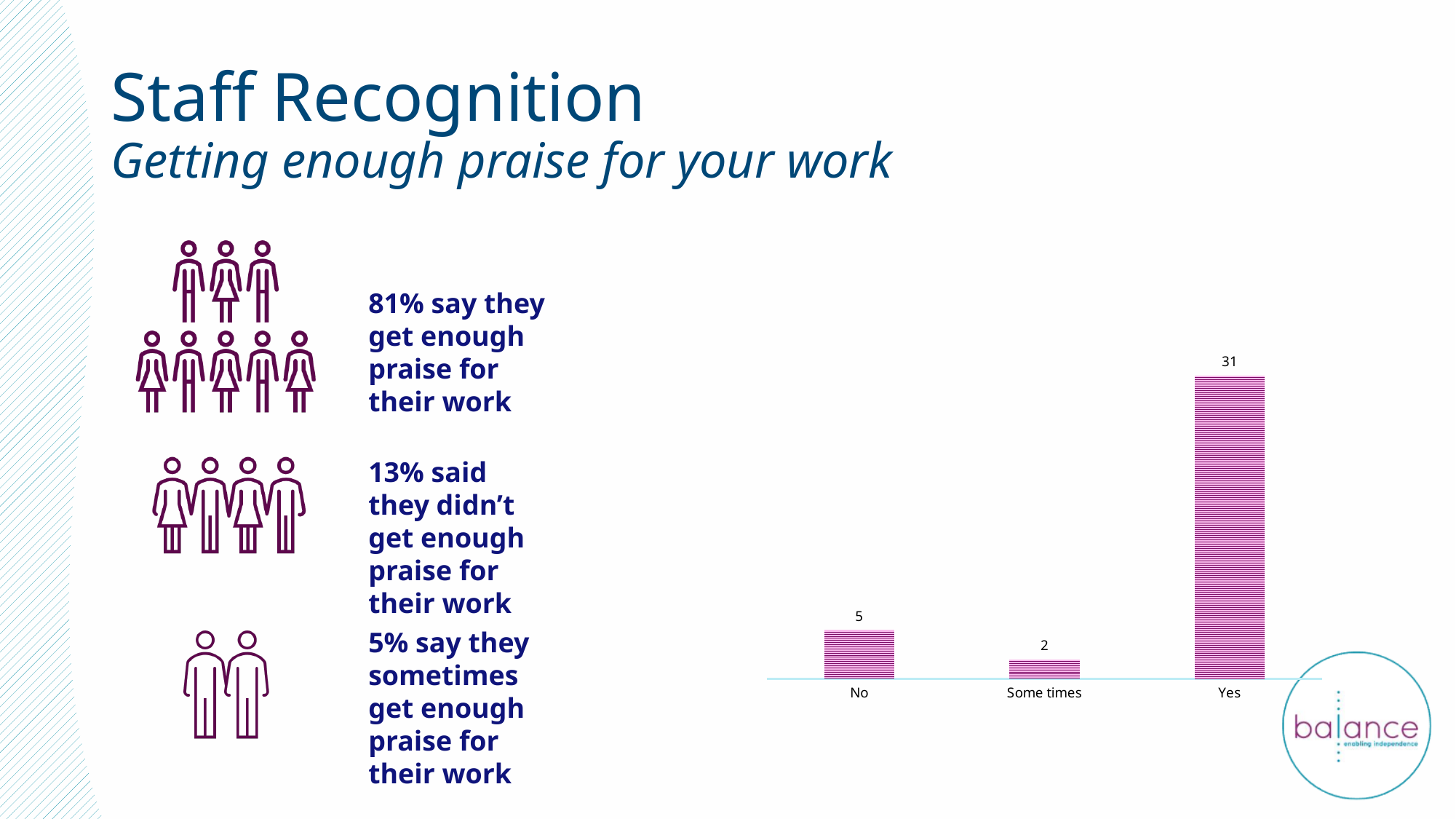
What is the difference between the "No" and "Some times" values in the chart? 3 What kind of chart is shown on the slide? Bar chart What is the value for the "Some times" bar in the chart? 2 Which is larger in the chart, the value for "No" or the value for "Some times"? No What is the value for the "No" bar in the chart? 5 What is the difference between the "Yes" and "No" values in the chart? 26 What is the total of all three bars in the chart? 38 What is the value for the "Yes" bar in the chart? 31 Which category has the lowest value in the chart? Some times How many categories are shown in the chart? 3 Which category has the highest value in the chart? Yes What colour are the bars in the chart? Pink/magenta